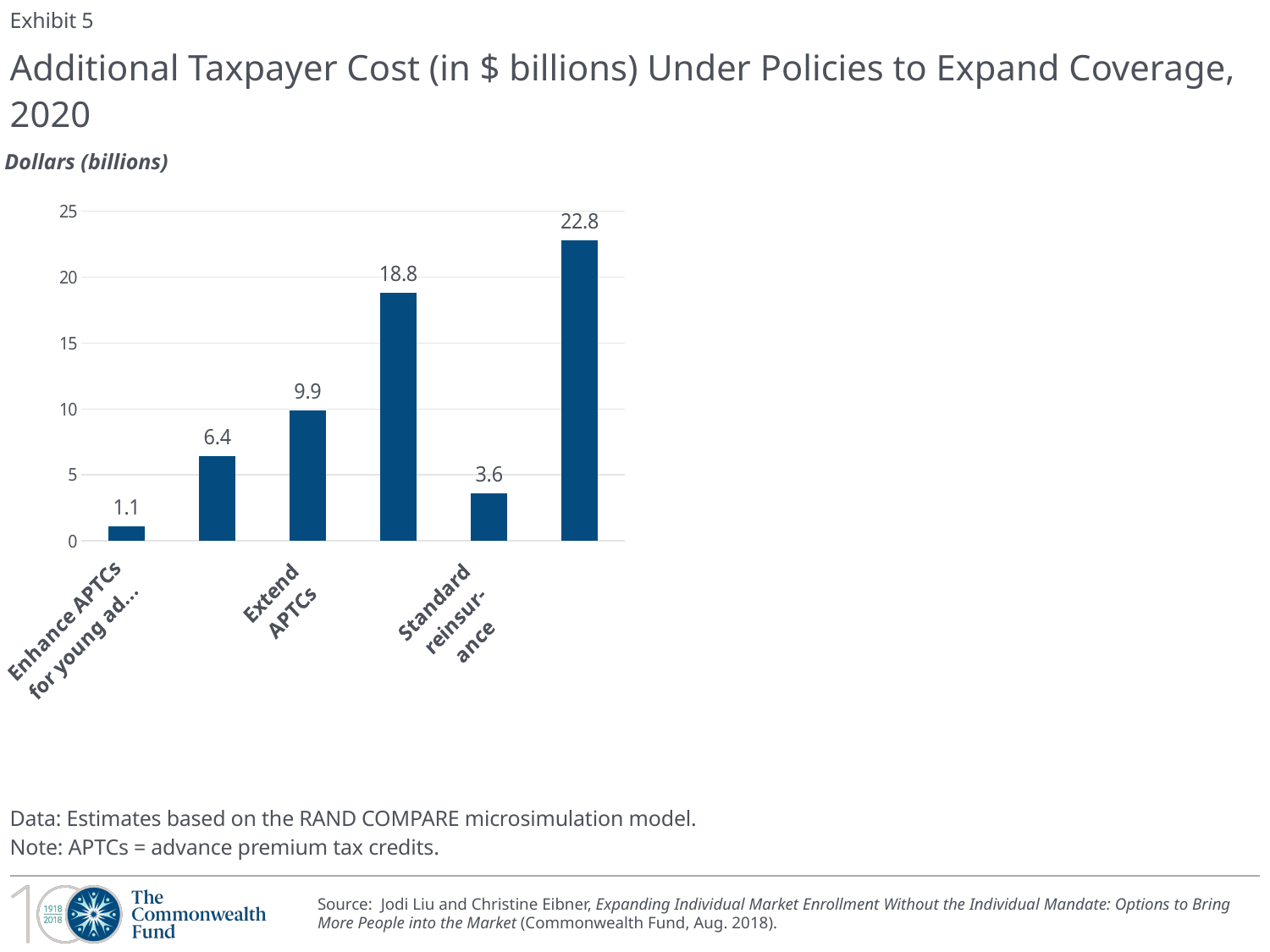
What type of chart is shown on the slide? bar chart How many bars are plotted in the chart? 6 Which has a higher additional taxpayer cost, Extend APTCs or Standard reinsurance? Extend APTCs What is the value of the first bar, labeled Enhance APTCs for young ad...? 1.1 Is the value for Extend APTCs greater or less than 10? less What is the additional taxpayer cost for Standard reinsurance? 3.6 What is the difference between the values for Extend APTCs and Standard reinsurance? 6.3 What is the additional taxpayer cost for Extend APTCs? 9.9 What is the maximum value shown on the y-axis? 25 What is the value of the tallest bar in the chart? 22.8 What is the y-axis label of the chart? Dollars (billions) What is the value of the shortest bar in the chart? 1.1